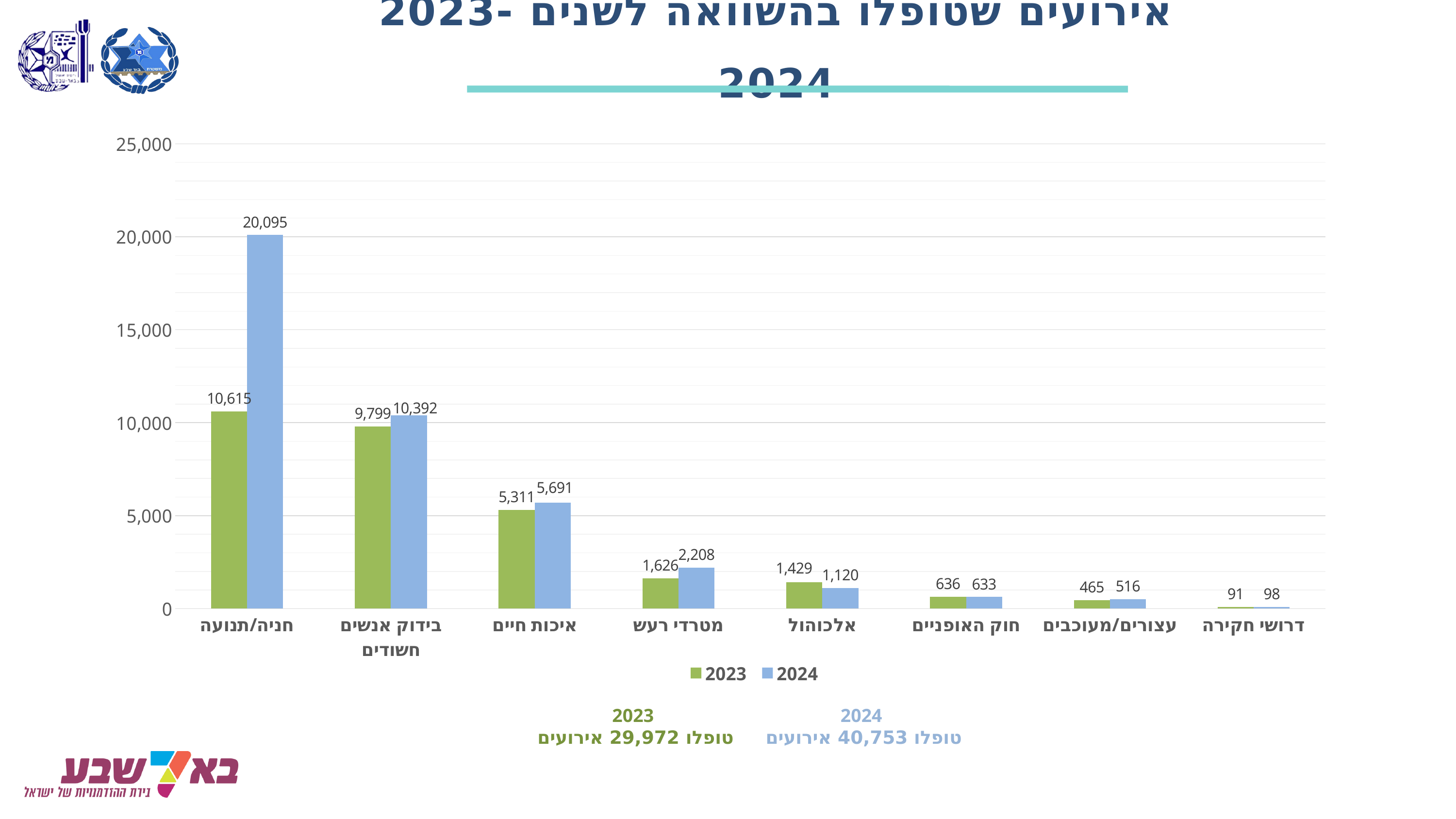
What kind of chart is shown on the slide? bar chart Which category has the lowest 2023 value? דרושי חקירה What is the 2024 value for מטרדי רעש? 2,208 What is the 2023 value for אלכוהול? 1,429 What is the 2023 value for בידוק אנשים חשודים? 9,799 What is the total number of events handled in 2024 according to the text below the chart? 40,753 Which category has the highest 2024 value? חניה/תנועה What is the difference between the 2024 and 2023 values for חניה/תנועה? 9,480 How many series does the legend list? 2 Which is larger for אלכוהול, the 2023 value or the 2024 value? 2023 What is the 2024 value for חניה/תנועה? 20,095 How many categories are shown on the x axis? 8